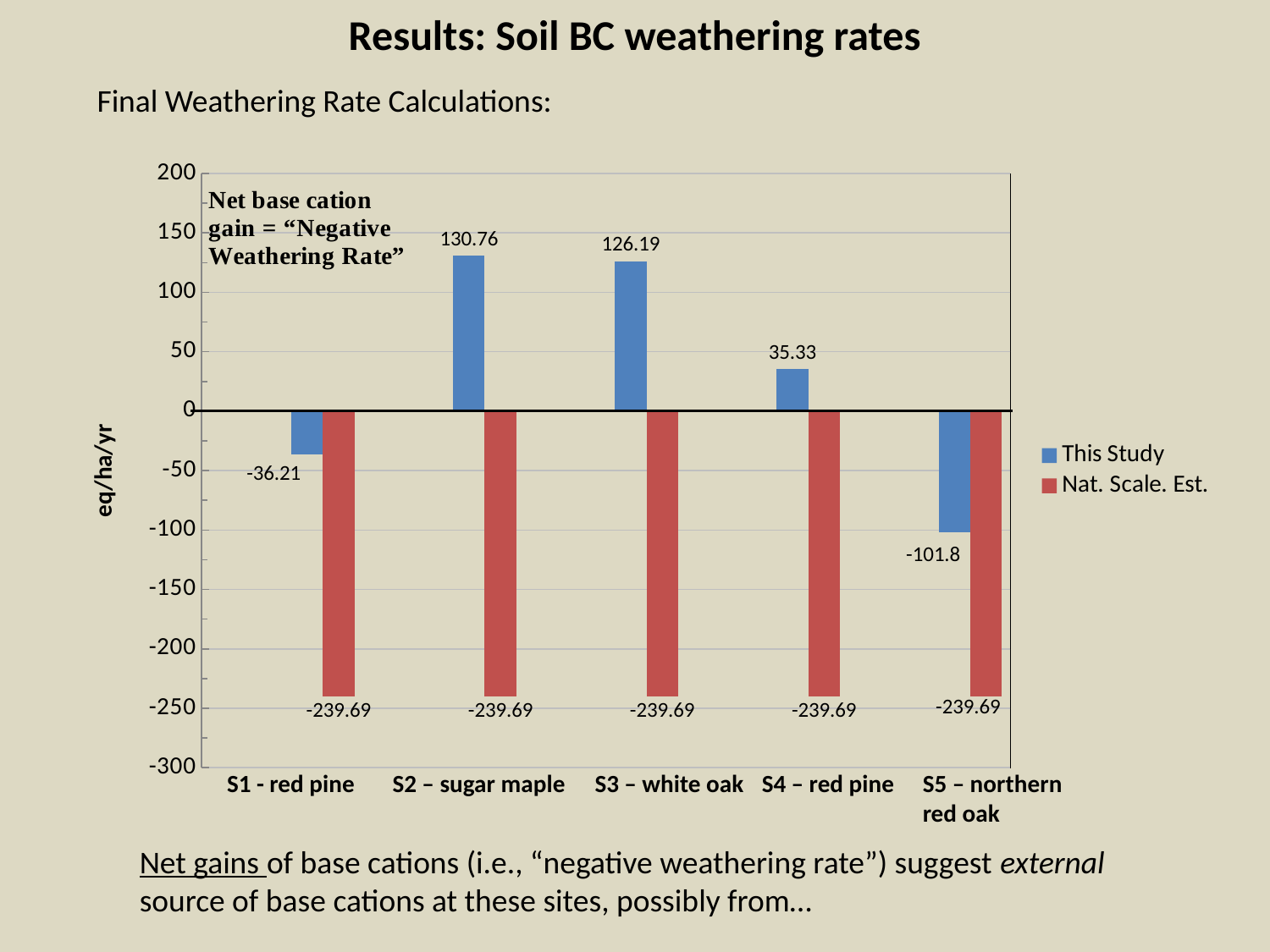
What is the Nat. Scale. Est. value at S3 – white oak? -239.69 What is the value for This Study at S2 – sugar maple? 130.76 What kind of chart is shown on the slide? Bar chart Which series is shown in red? Nat. Scale. Est. What is the value for This Study at S5 – northern red oak? -101.8 Which site has the highest This Study value? S2 – sugar maple What is the difference between the This Study values at S2 – sugar maple and S3 – white oak? 4.57 How many series does the legend list? 2 How many sites are shown on the x axis? 5 Which is larger, the This Study value at S4 – red pine or at S1 - red pine? S4 – red pine What is the label on the y axis? eq/ha/yr Which site has the lowest This Study value? S5 – northern red oak